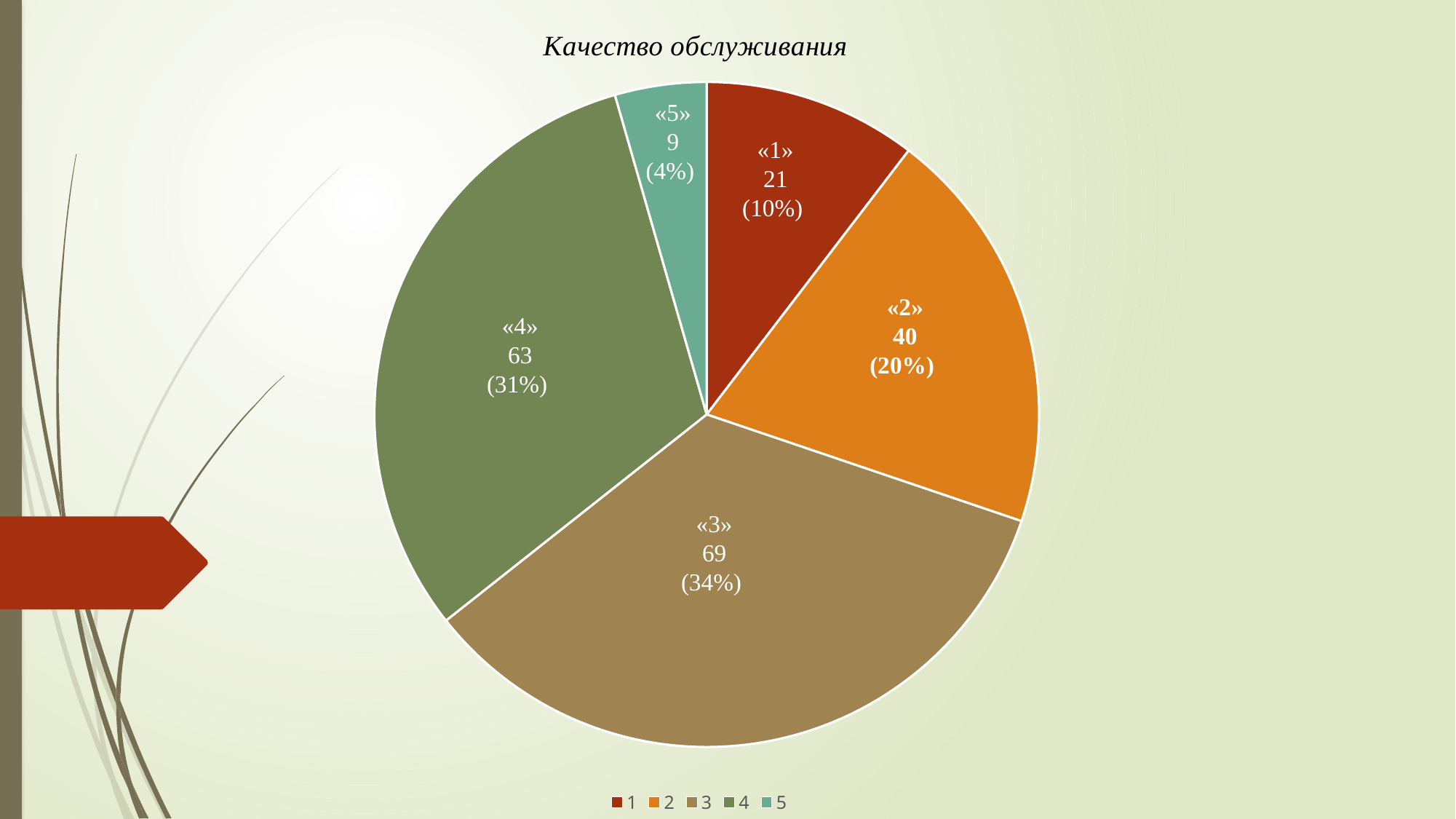
What is the difference between the values for «3» and «4»? 6 What is the difference between the values for «2» and «1»? 19 What is the title of the chart? Качество обслуживания What percentage share does category «4» have? 31% Which category has the smallest slice? «5» Which is larger, the value for «1» or the value for «2»? «2» Which category has the largest slice? «3» How many categories does the pie chart show? 5 What kind of chart is shown on the slide? pie chart What is the value for category «3»? 69 What is the value for category «5»? 9 What percentage share does category «2» have? 20%